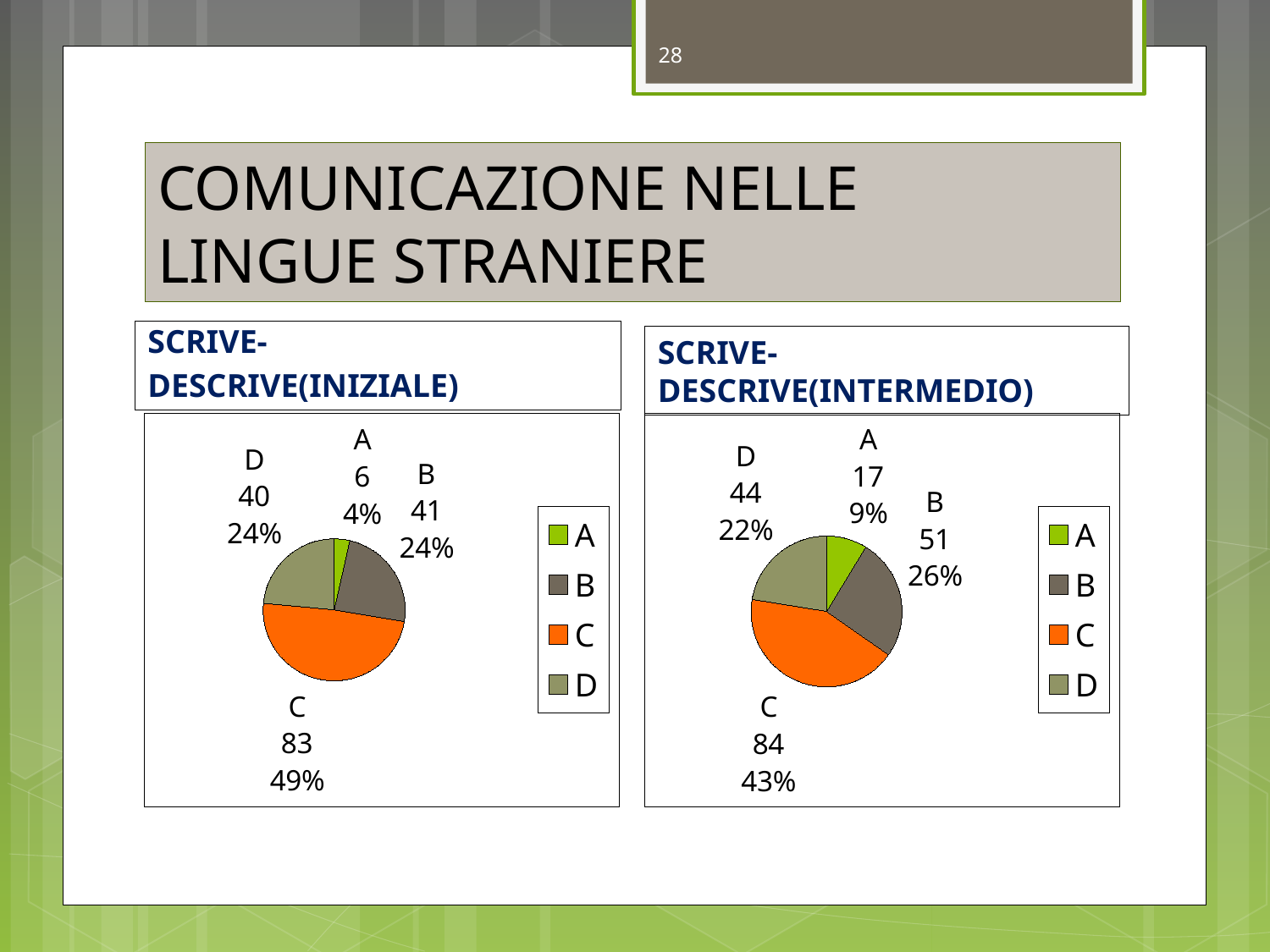
In the SCRIVE-DESCRIVE(INTERMEDIO) chart, what is the difference between the values for C and D? 40 In the SCRIVE-DESCRIVE(INIZIALE) chart, what is the value for category C? 83 In the SCRIVE-DESCRIVE(INTERMEDIO) chart, what colour is the slice for category C? Orange In the SCRIVE-DESCRIVE(INTERMEDIO) chart, which category has the smallest slice? A In the SCRIVE-DESCRIVE(INTERMEDIO) chart, what is the value for category B? 51 In the SCRIVE-DESCRIVE(INIZIALE) chart, what percentage share does category D have? 24% In the SCRIVE-DESCRIVE(INIZIALE) chart, which is larger, the value for B or the value for A? B In the SCRIVE-DESCRIVE(INIZIALE) chart, which category has the largest slice? C In the SCRIVE-DESCRIVE(INIZIALE) chart, what is the total of all four categories? 170 How many categories does the SCRIVE-DESCRIVE(INTERMEDIO) chart show? 4 What kind of chart is the SCRIVE-DESCRIVE(INIZIALE) chart? Pie chart In the SCRIVE-DESCRIVE(INTERMEDIO) chart, what percentage share does category A have? 9%